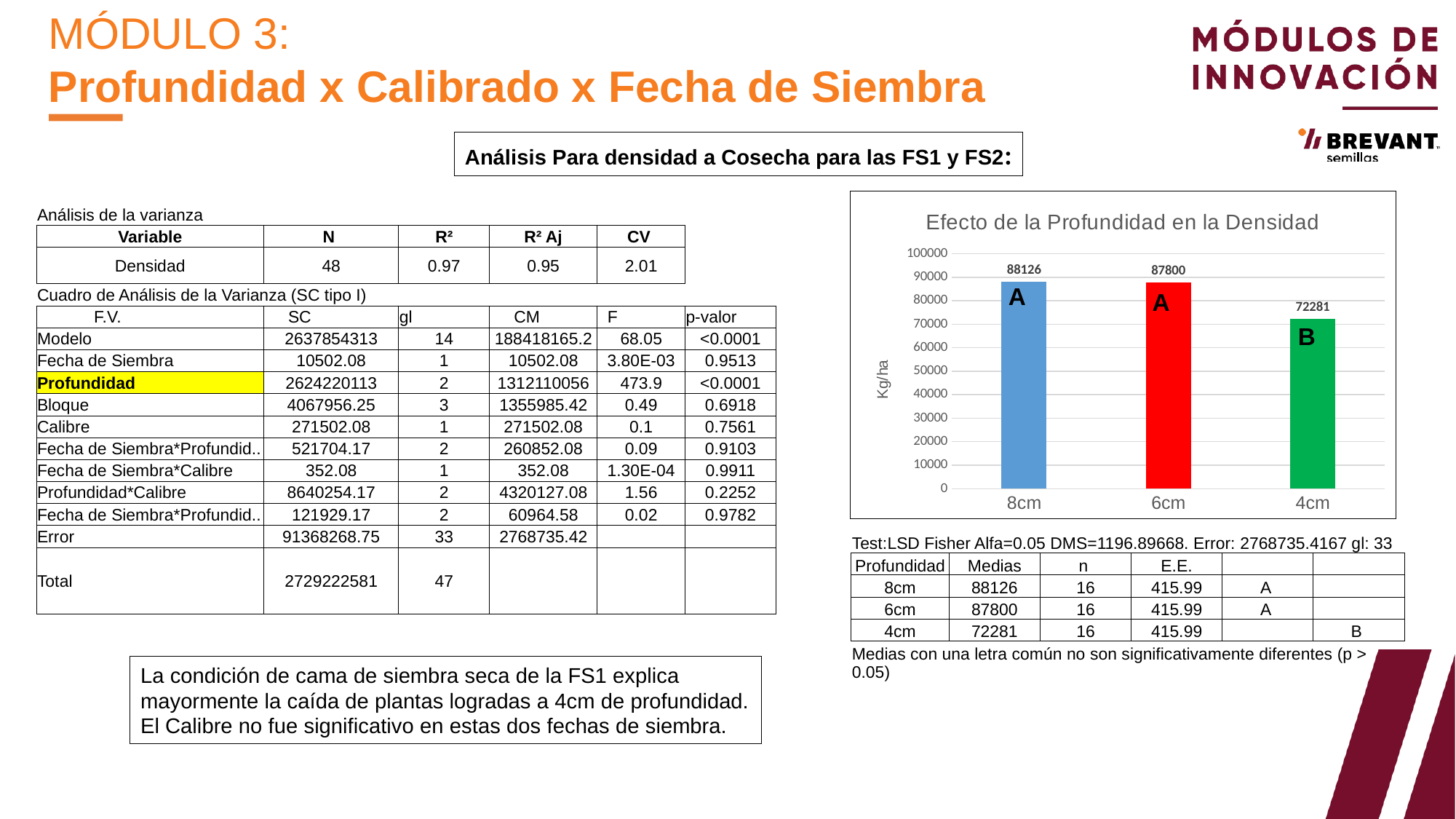
What is the difference between the values for 6cm and 4cm in the chart 'Efecto de la Profundidad en la Densidad'? 15519 How many categories are shown in the chart 'Efecto de la Profundidad en la Densidad'? 3 What is the value for 8cm in the chart 'Efecto de la Profundidad en la Densidad'? 88126 What kind of chart is 'Efecto de la Profundidad en la Densidad'? bar chart What is the y-axis label of the chart 'Efecto de la Profundidad en la Densidad'? Kg/ha Which category has the lowest value in the chart 'Efecto de la Profundidad en la Densidad'? 4cm What is the value for 6cm in the chart 'Efecto de la Profundidad en la Densidad'? 87800 Is the value for 4cm greater or less than 80000 in the chart 'Efecto de la Profundidad en la Densidad'? less What is the difference between the values for 8cm and 4cm in the chart 'Efecto de la Profundidad en la Densidad'? 15845 Which category has the highest value in the chart 'Efecto de la Profundidad en la Densidad'? 8cm What colour is the bar for 4cm in the chart 'Efecto de la Profundidad en la Densidad'? green What is the value for 4cm in the chart 'Efecto de la Profundidad en la Densidad'? 72281